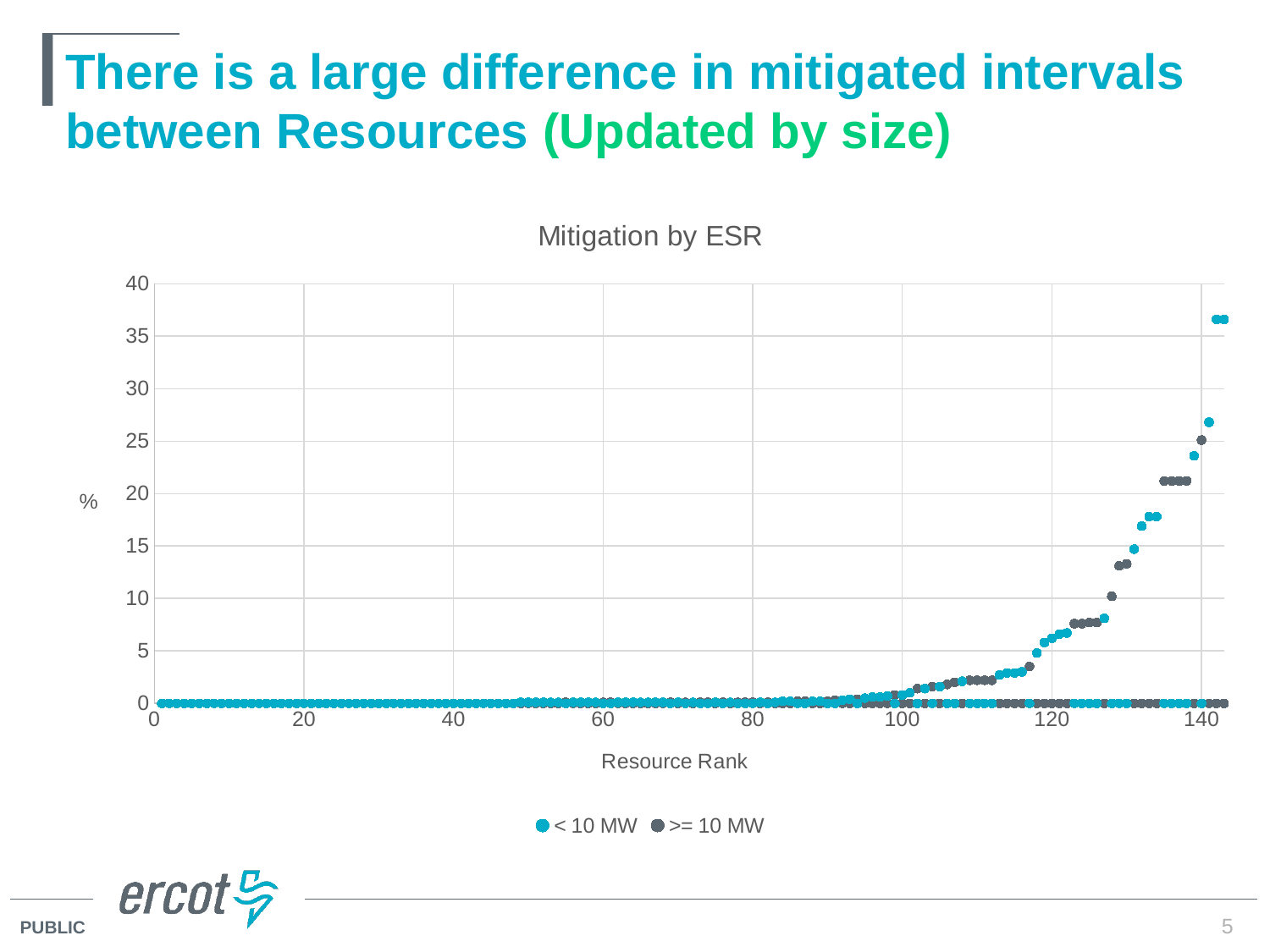
How many series does the legend list? 2 Are the values plotted at Resource Rank 20 greater or less than 5? less Is the highest value of the >= 10 MW series greater or less than 30? less Is the highest plotted value on the chart greater or less than 35? greater Which has the larger plotted value: the point at Resource Rank 140 or the point at Resource Rank 40? Resource Rank 140 What is the label of the x axis? Resource Rank Do the plotted values rise or fall as Resource Rank increases along the x axis? Rise What are the two series named in the legend? < 10 MW and >= 10 MW What kind of chart is shown on the slide? Scatter chart What is the highest tick value shown on the y axis? 40 Which series contains the highest plotted value on the chart? < 10 MW